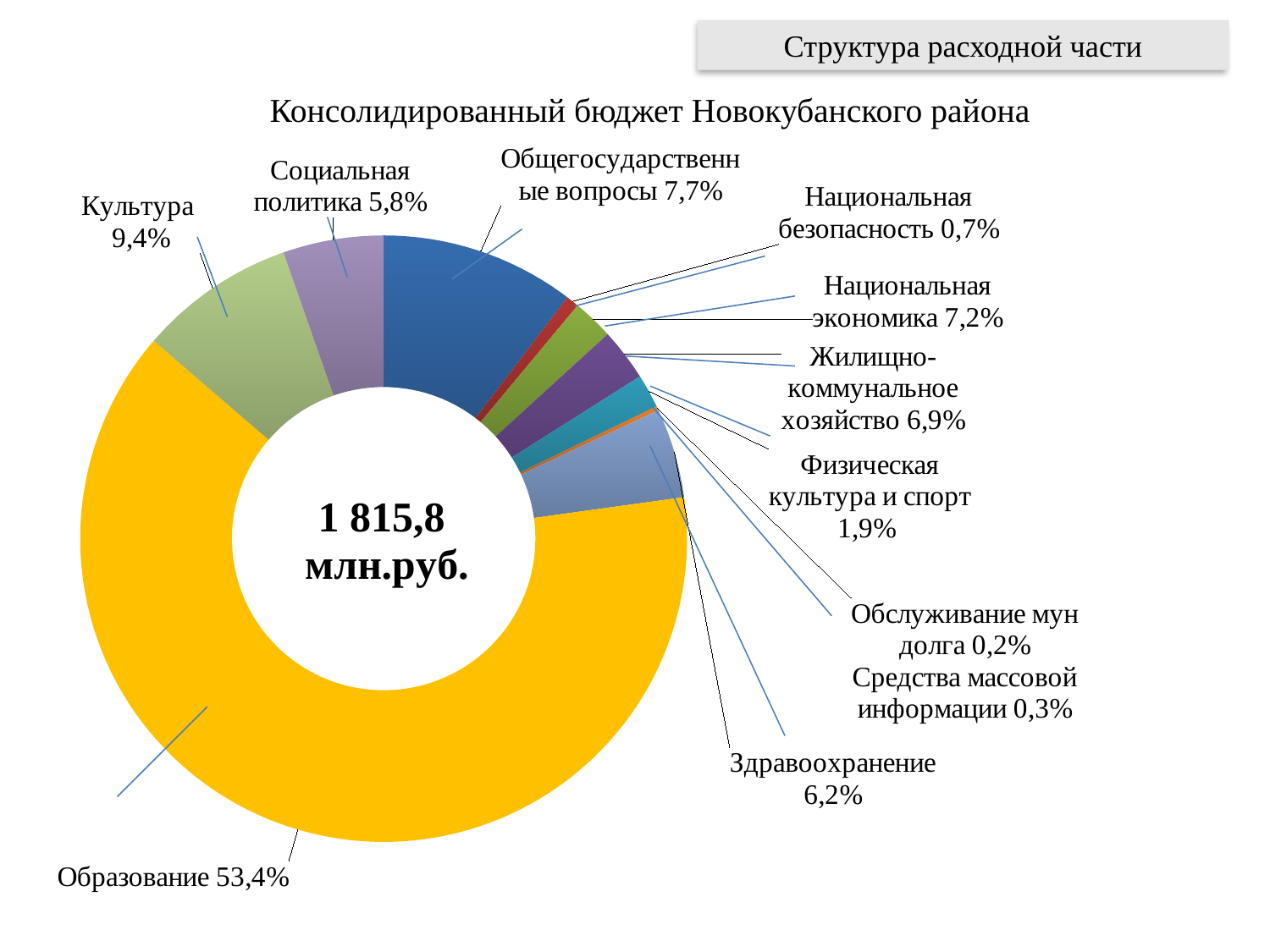
What share of expenditure is labelled for Здравоохранение (healthcare)? 6,2% How many expenditure categories are shown in the chart? 11 What total amount is printed in the centre of the chart? 1 815,8 млн.руб. What is the title of the chart? Консолидированный бюджет Новокубанского района Which has a larger share: Общегосударственные вопросы or Национальная экономика? Общегосударственные вопросы What is the difference in percentage points between Культура and Социальная политика? 3,6 What share of the consolidated budget expenditure goes to Образование (education)? 53,4% Which has a larger share: Физическая культура и спорт or Национальная безопасность? Физическая культура и спорт Which category has the smallest share of the expenditure structure? Обслуживание мун долга Which category has the largest share of the expenditure structure? Образование What percentage is shown for Жилищно-коммунальное хозяйство? 6,9% What type of chart is used on the slide? Pie (doughnut) chart